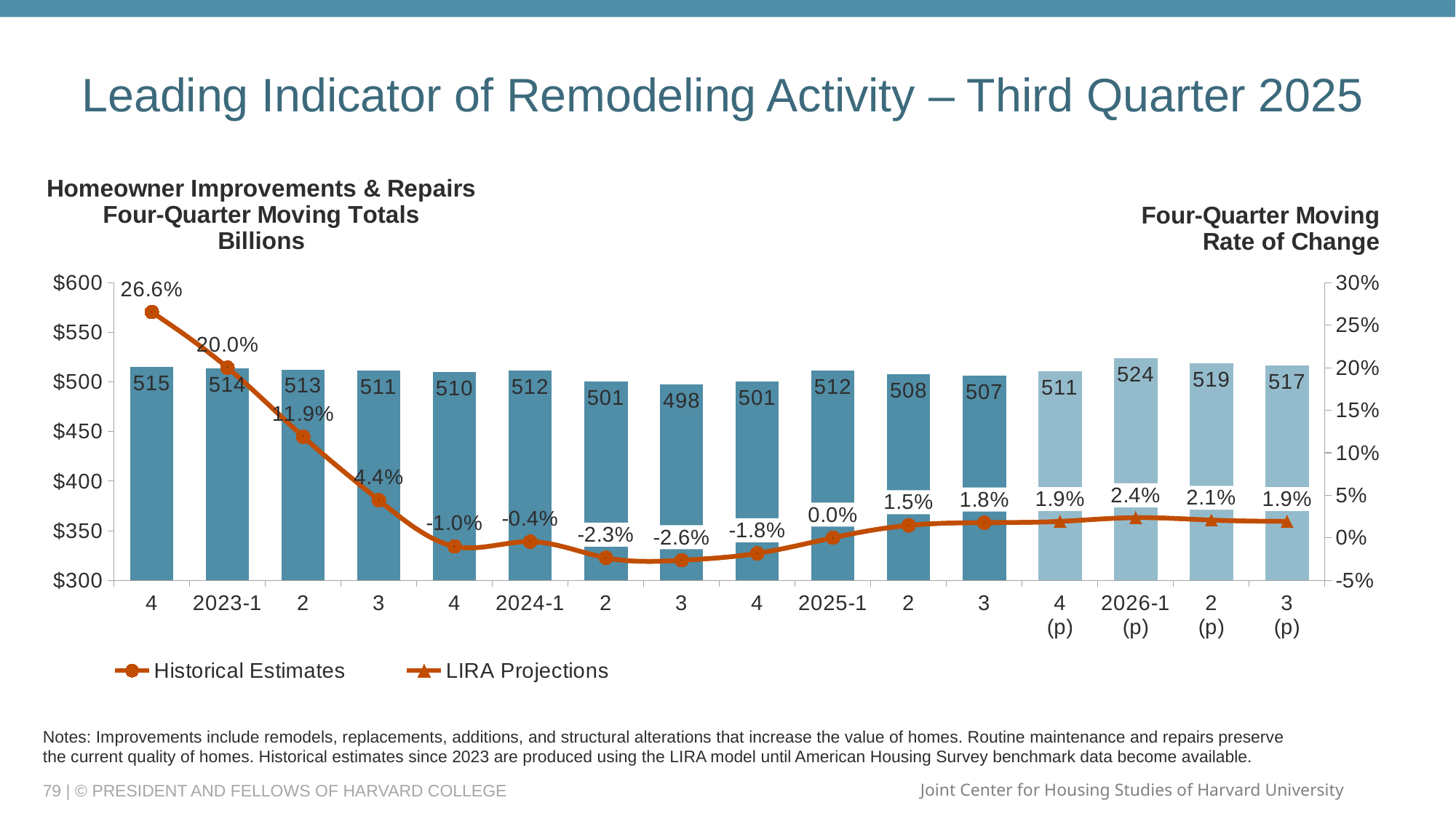
Which is larger, the four-quarter moving total for 2023-1 or for quarter 2 of 2024? 2023-1 (514) How many series does the legend list? 2 How many quarters are plotted along the x axis? 16 What is the four-quarter moving rate of change shown for quarter 3 of 2024? -2.6% What is the four-quarter moving total (in billions) shown for 2025-1? 512 What is the projected rate of change shown for 2026-1 (p)? 2.4% Which quarter has the lowest four-quarter moving total bar? 3 (2024-3) What is the difference between the highest bar value (524) and the lowest bar value (498)? 26 Which quarter has the lowest four-quarter moving rate of change on the line? 3 (2024-3), at -2.6% Which quarter has the highest four-quarter moving total bar? 2026-1 (p) Does the four-quarter moving rate of change rise or fall from the first quarter shown (26.6%) to quarter 3 of 2024? Fall What is the title of the right-hand axis? Four-Quarter Moving Rate of Change